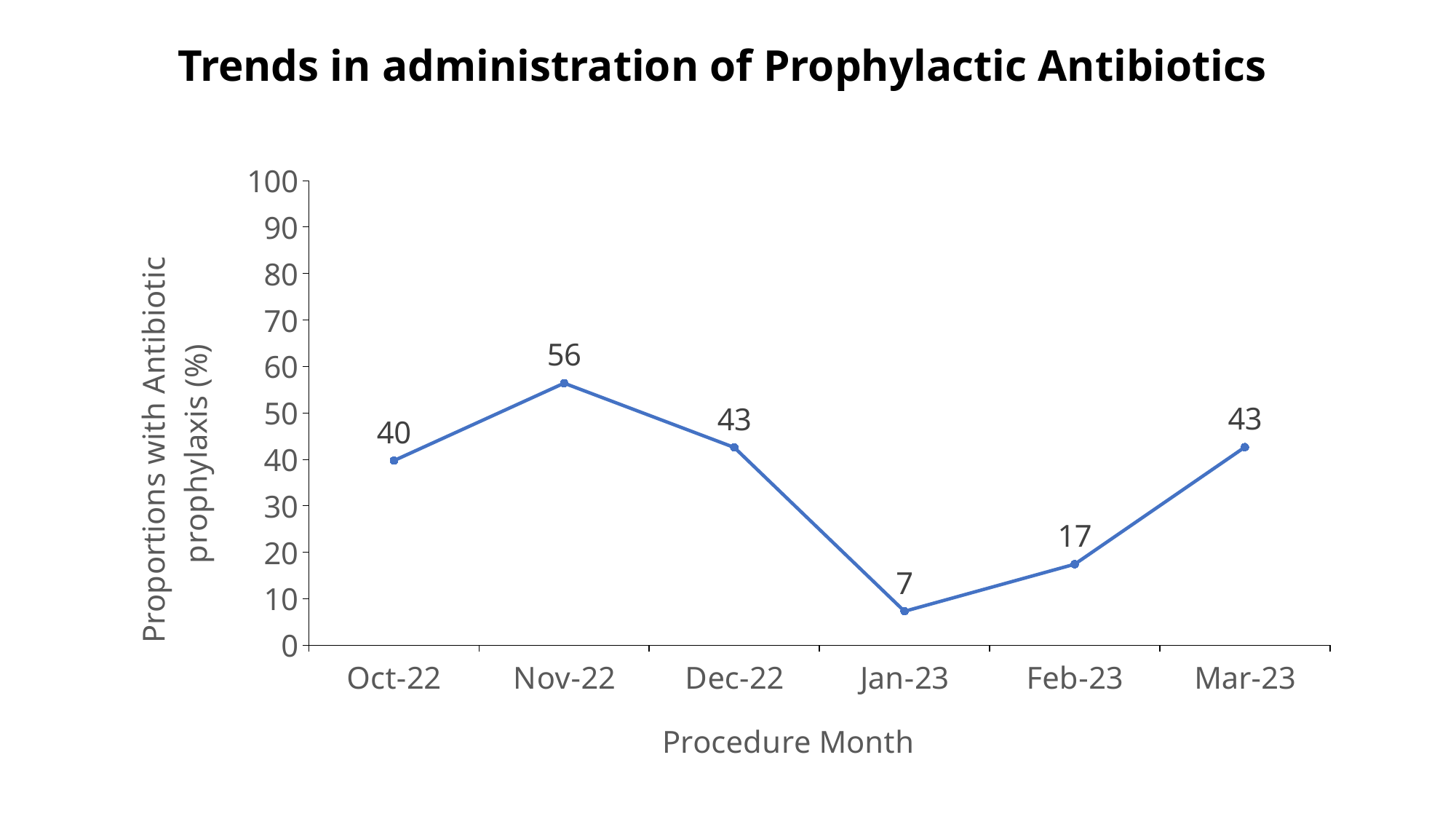
Is the value for Oct-22 greater or less than 50? less What is the value for Nov-22? 56 What is the value for Feb-23? 17 Which is larger, the value for Oct-22 or the value for Dec-22? Dec-22 What is the value for Jan-23? 7 What is the difference between the values for Mar-23 and Feb-23? 26 Which month has the highest proportion with antibiotic prophylaxis? Nov-22 Which month has the lowest proportion with antibiotic prophylaxis? Jan-23 What kind of chart is shown on the slide? line chart What is the difference between the values for Nov-22 and Jan-23? 49 What is the title of the chart? Trends in administration of Prophylactic Antibiotics How many months are plotted on the chart? 6